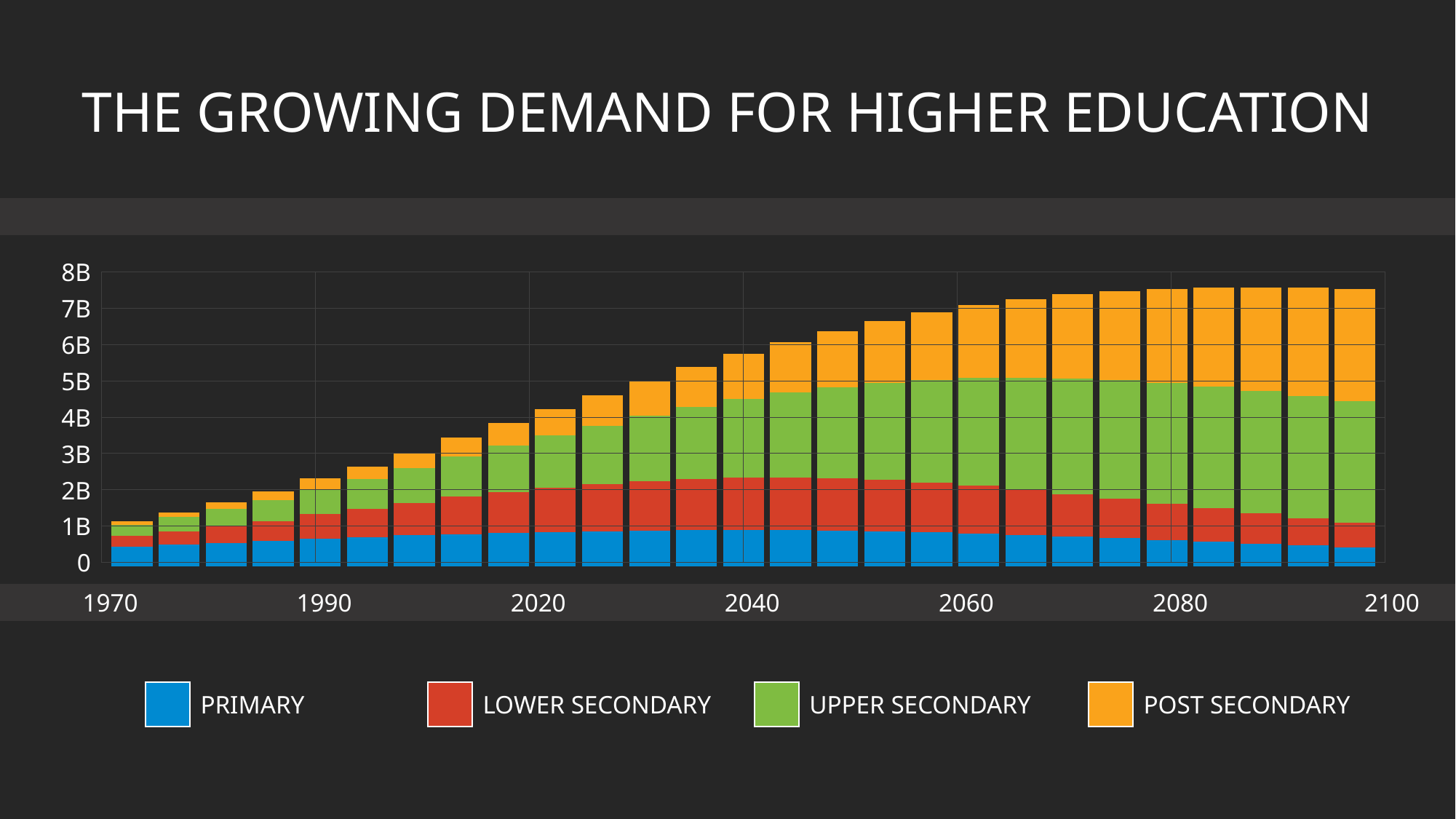
Is the total height of the bar for 2060 greater or less than 6B? greater Which year has the lowest total bar height? 1970 Is the PRIMARY segment of the 2100 bar greater or less than 1B? less Is the total height of the bar for 2100 greater or less than 7B? greater Which series is shown in orange in the legend? POST SECONDARY What type of chart is shown on the slide? Stacked bar chart What is the title of the slide containing the chart? THE GROWING DEMAND FOR HIGHER EDUCATION Do the total bar heights generally rise or fall from 1970 to 2060? Rise Which bar is taller in total, 2020 or 2040? 2040 How many series does the legend list? 4